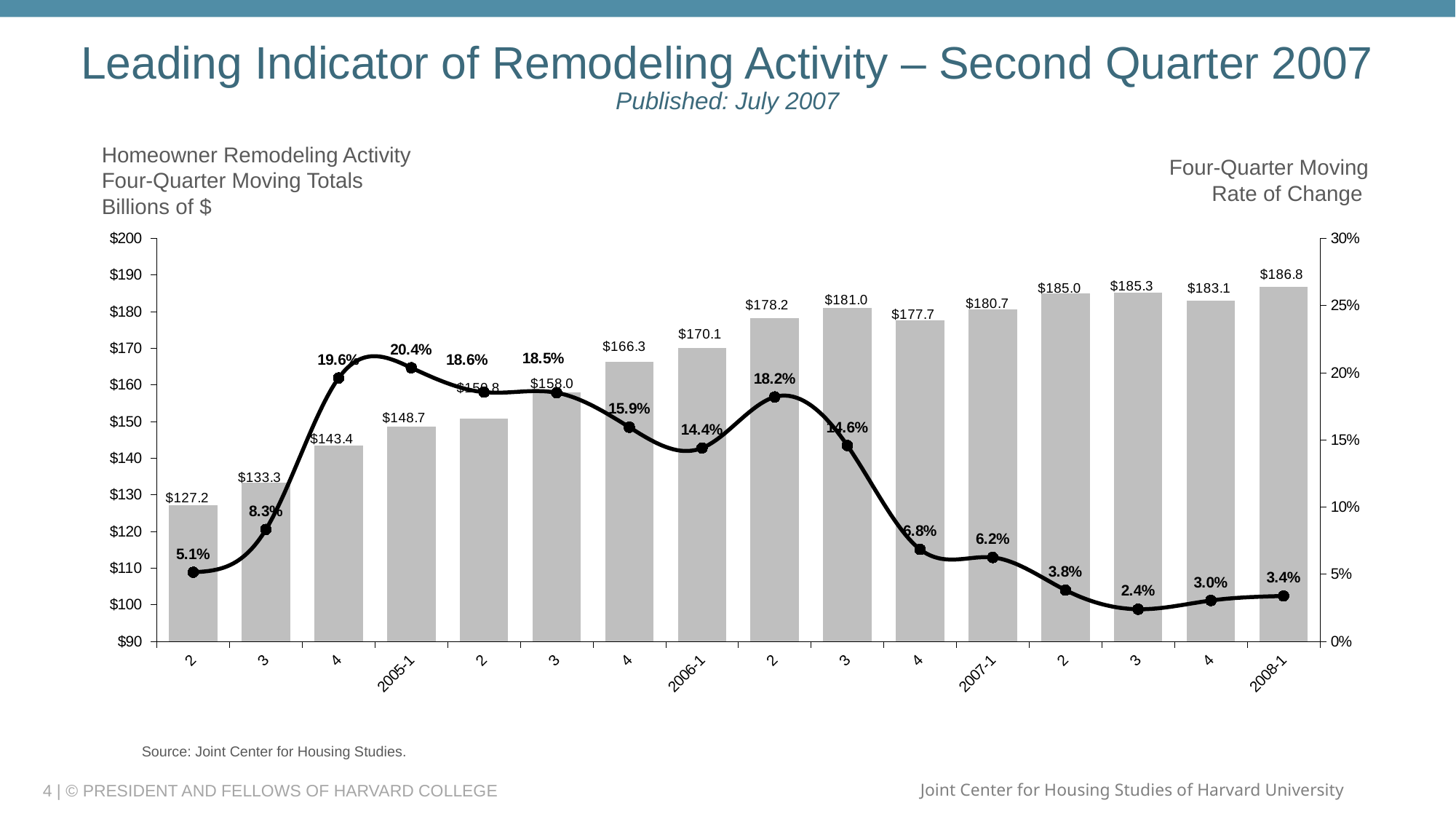
Does the four-quarter moving rate of change rise or fall from the 2006 second quarter to the 2007 third quarter? Fall Which has the larger four-quarter moving total, 2006-1 or 2007-1? 2007-1 What is the highest four-quarter moving rate of change shown on the line? 20.4% How many quarters are plotted along the x axis? 16 How much larger is the four-quarter moving total for 2008-1 than for 2007-1, in billions of dollars? $6.1 What kind of chart is shown on the slide? Combination bar and line chart What is the four-quarter moving total of homeowner remodeling activity for 2007-1? $180.7 What is the four-quarter moving rate of change shown for 2006-1? 14.4% What is the lowest four-quarter moving total shown by the bars? $127.2 Which quarter has the highest four-quarter moving total (bar) on the chart? 2008-1 What is the lowest four-quarter moving rate of change shown on the line? 2.4% What does the right-hand axis of the chart measure? Four-Quarter Moving Rate of Change